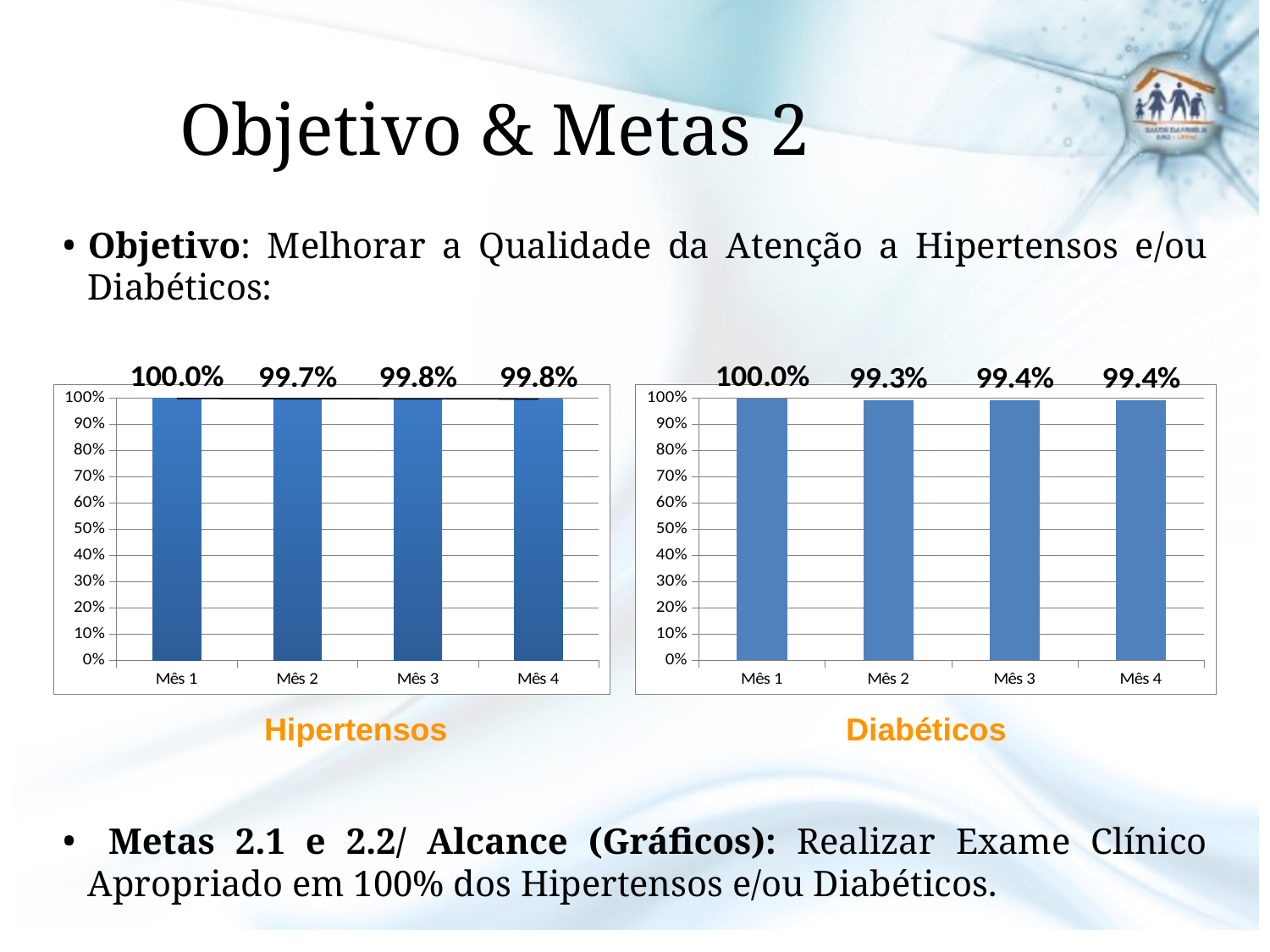
In the Hipertensos chart, what is the value for Mês 2? 99.7% In the Diabéticos chart, what is the difference between the values for Mês 1 and Mês 2? 0.7% In the Diabéticos chart, which month has the lowest value? Mês 2 In the Hipertensos chart, what is the value for Mês 4? 99.8% In the Hipertensos chart, what is the difference between the values for Mês 1 and Mês 2? 0.3% In the Hipertensos chart, what is the value for Mês 1? 100.0% In the Diabéticos chart, what is the value for Mês 3? 99.4% What type of chart is the Diabéticos chart? bar chart How many months are shown in the Hipertensos chart? 4 Which is larger: the Mês 2 value in the Hipertensos chart or the Mês 2 value in the Diabéticos chart? Hipertensos In the Hipertensos chart, which month has the highest value? Mês 1 In the Diabéticos chart, is the value for Mês 4 greater or less than 90%? greater